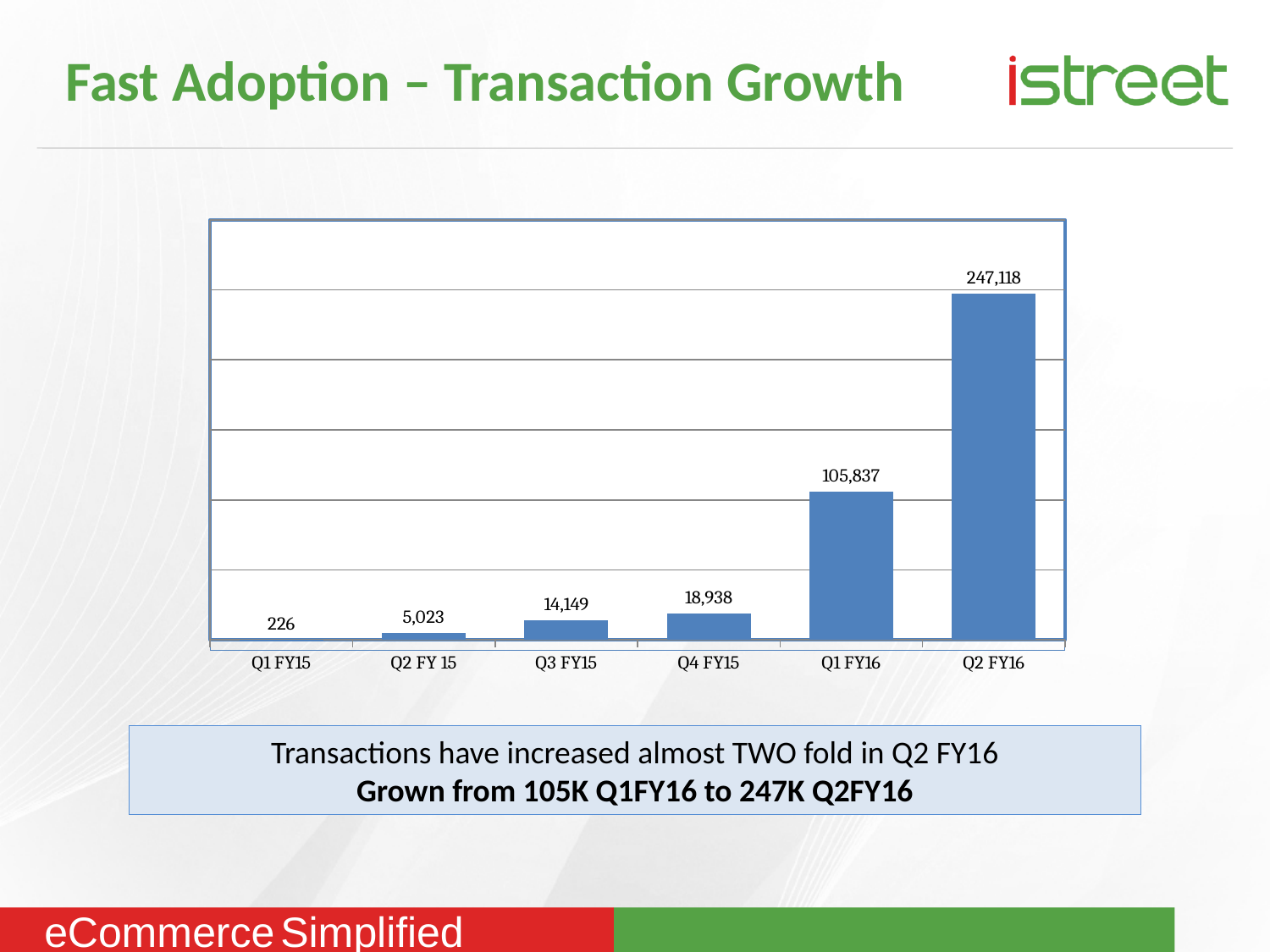
Which quarter has the lowest value? Q1 FY15 What kind of chart is shown on the slide? Bar chart Which quarter has the highest value? Q2 FY16 What is the value for Q3 FY15? 14,149 What is the value for Q1 FY15? 226 Do the values rise or fall from Q1 FY15 to Q2 FY16? Rise What is the value for Q2 FY16? 247,118 What is the difference between the values for Q4 FY15 and Q3 FY15? 4,789 What is the difference between the values for Q2 FY16 and Q1 FY16? 141,281 What is the value for Q4 FY15? 18,938 Which is larger, the value for Q2 FY 15 or the value for Q3 FY15? Q3 FY15 How many quarters are shown on the chart? 6